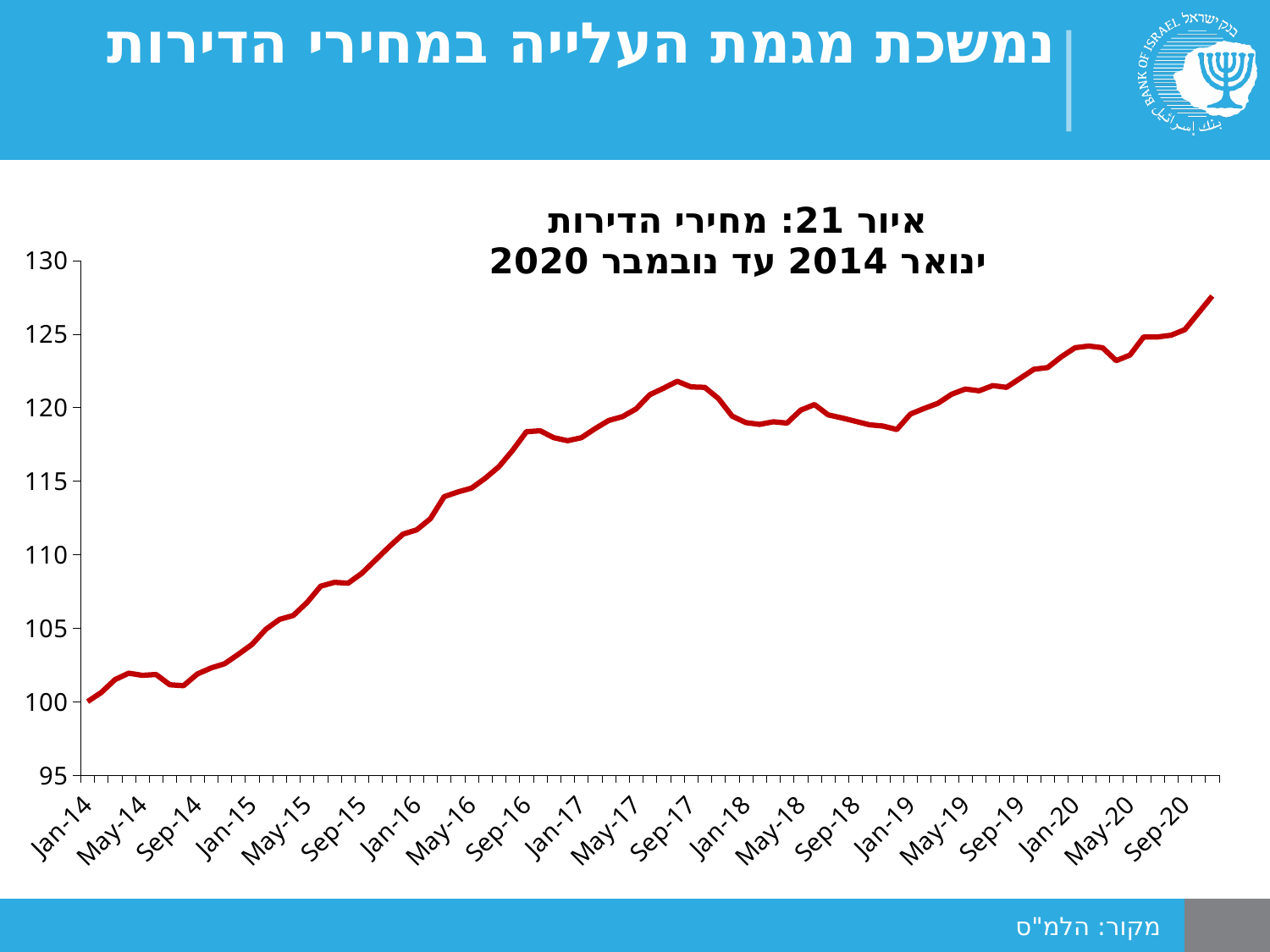
At which point on the x axis is the index lowest? Jan-14 Is the value at Jan-16 greater or less than 110? greater What kind of chart is shown on the slide? line chart Is the value at Sep-14 greater or less than 105? less What is the title of the chart? איור 21: מחירי הדירות ינואר 2014 עד נובמבר 2020 What is the value of the index at Jan-14? 100 Do the values generally rise or fall from Jan-14 to Sep-20? rise Is the value at Jan-20 greater or less than 120? greater What source is cited for the chart? הלמ"ס Which is higher, the value at Sep-17 or the value at Jan-19? Sep-17